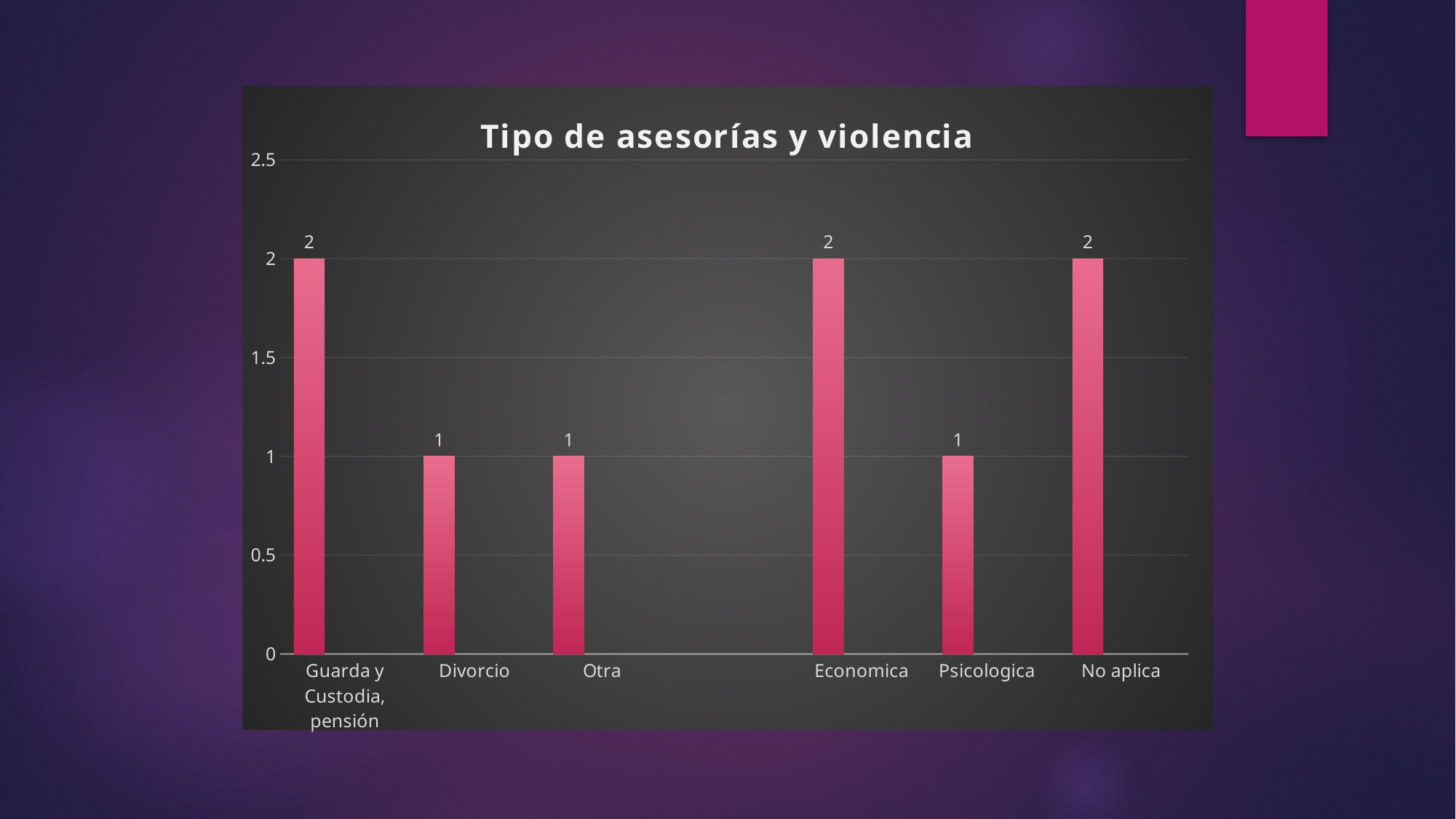
What is the difference between the value for Economica and the value for Otra? 1 What is the title of the chart? Tipo de asesorías y violencia What kind of chart is shown on the slide? Bar chart What is the value for Divorcio in the chart? 1 How many bars are plotted in the chart? 6 Which is larger, the value for Psicologica or the value for No aplica? No aplica What is the value for Guarda y Custodia, pensión in the chart? 2 Which is larger, the value for Guarda y Custodia, pensión or the value for Divorcio? Guarda y Custodia, pensión What is the value for Economica in the chart? 2 What is the value for Otra in the chart? 1 What is the value for No aplica in the chart? 2 What is the value for Psicologica in the chart? 1